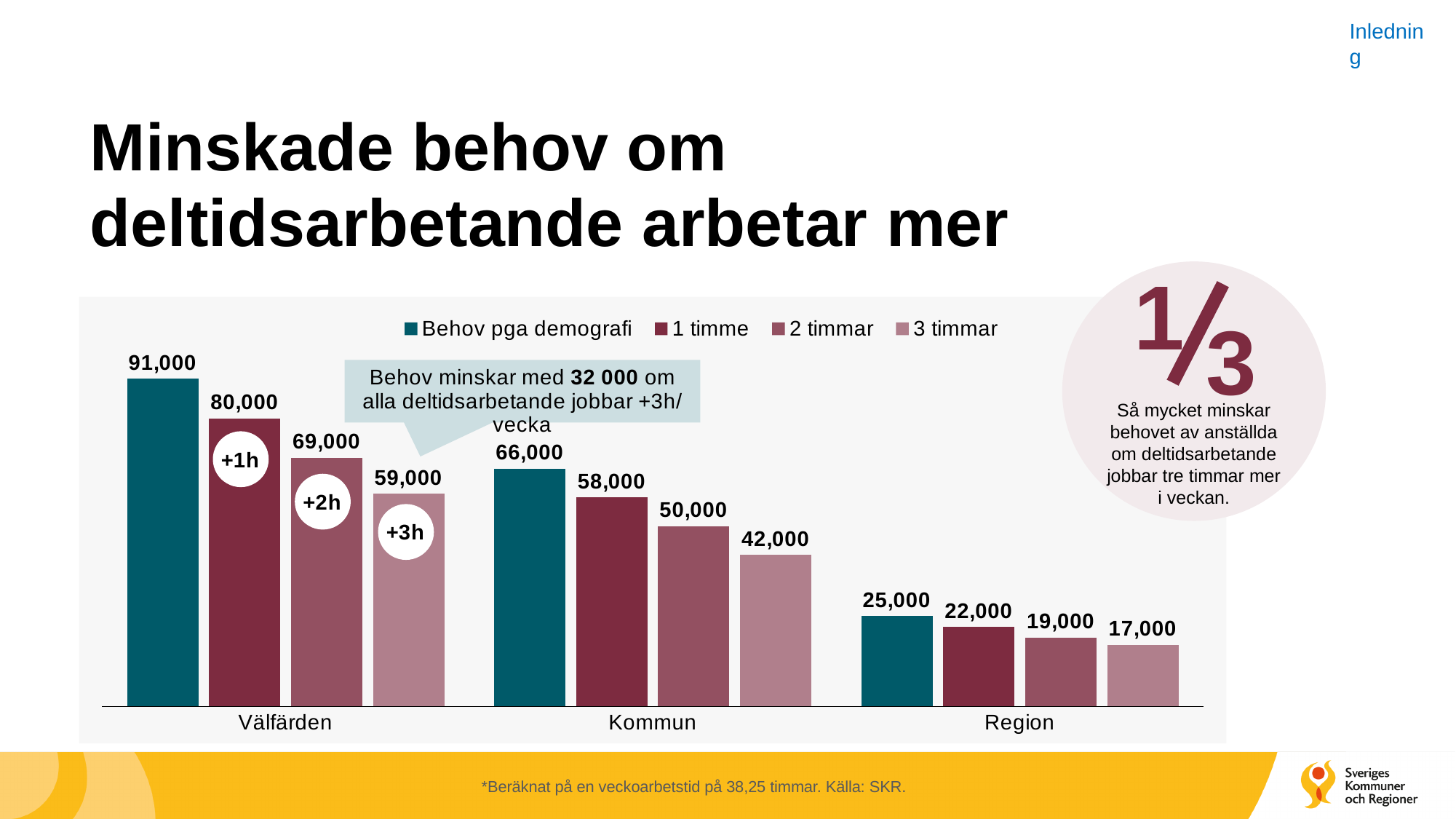
What is the difference between '1 timme' and '2 timmar' for Kommun? 8,000 How many categories are shown on the x axis? 3 Within each category, do the values rise or fall from 'Behov pga demografi' to '3 timmar'? Fall What is the value of '1 timme' for Region? 22,000 Which category has the highest 'Behov pga demografi' value? Välfärden What is the difference between 'Behov pga demografi' and '3 timmar' for Välfärden? 32,000 Which category has the lowest '2 timmar' value? Region What is the value of 'Behov pga demografi' for Välfärden? 91,000 Which is larger: '2 timmar' for Välfärden or 'Behov pga demografi' for Kommun? 2 timmar for Välfärden How many series does the legend list? 4 What kind of chart is shown on the slide? Bar chart What is the value of '3 timmar' for Kommun? 42,000